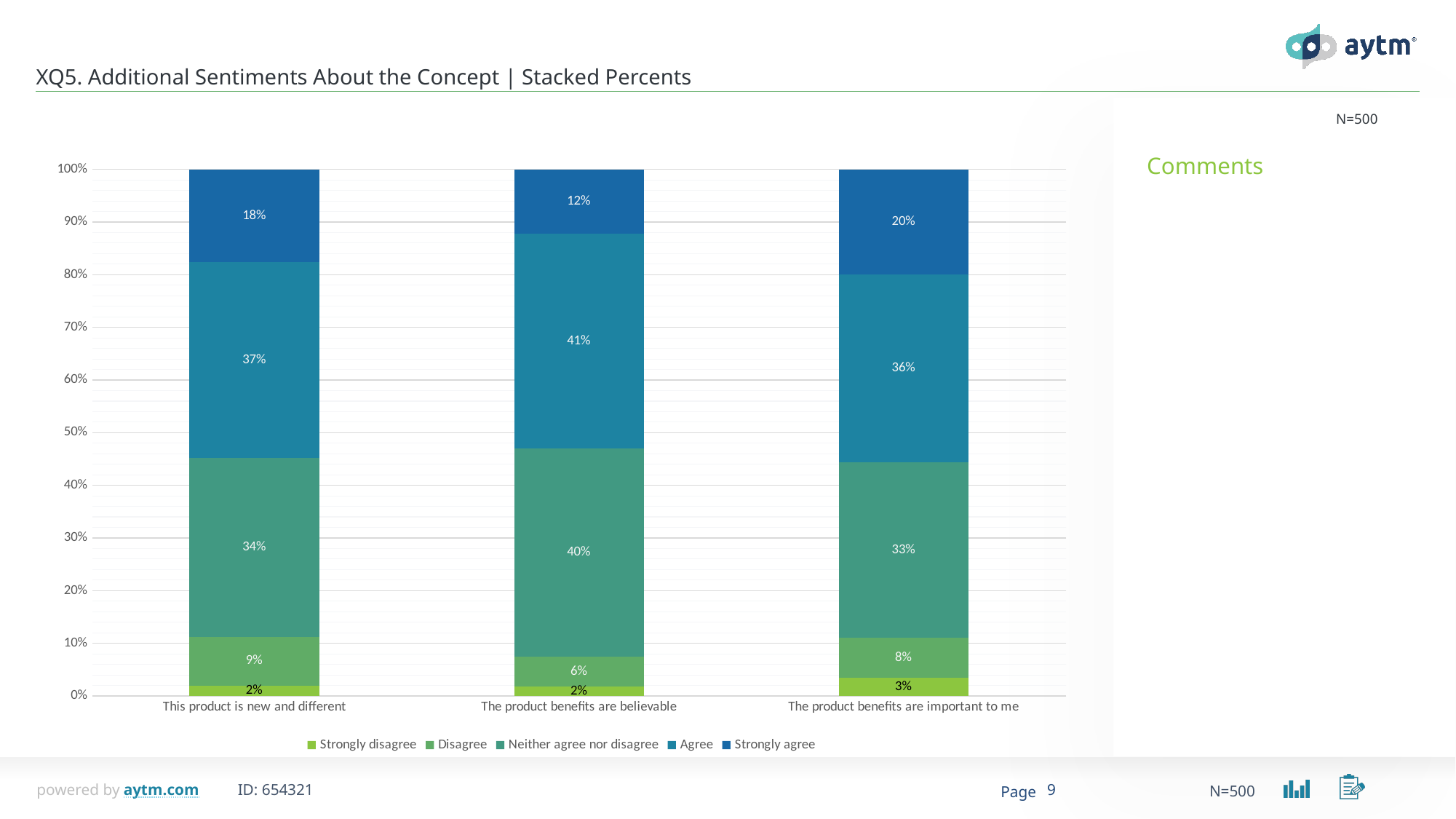
What percentage of respondents strongly agree that the product benefits are important to them? 20% How many statements (categories) are shown on the x axis? 3 Is the 'Neither agree nor disagree' percentage higher for 'The product benefits are believable' or for 'This product is new and different'? The product benefits are believable What percentage of respondents neither agree nor disagree that the product benefits are important to them? 33% What type of chart is shown on the slide? Stacked bar chart Which statement has the highest 'Strongly agree' percentage? The product benefits are important to me What is the combined percentage of 'Agree' and 'Strongly agree' for 'This product is new and different'? 55% What percentage of respondents agree that the product benefits are believable? 41% What percentage of respondents disagree that this product is new and different? 9% What is the difference between the 'Agree' percentages for 'The product benefits are believable' and 'This product is new and different'? 4% Which statement has the lowest 'Strongly agree' percentage? The product benefits are believable How many series does the legend list? 5